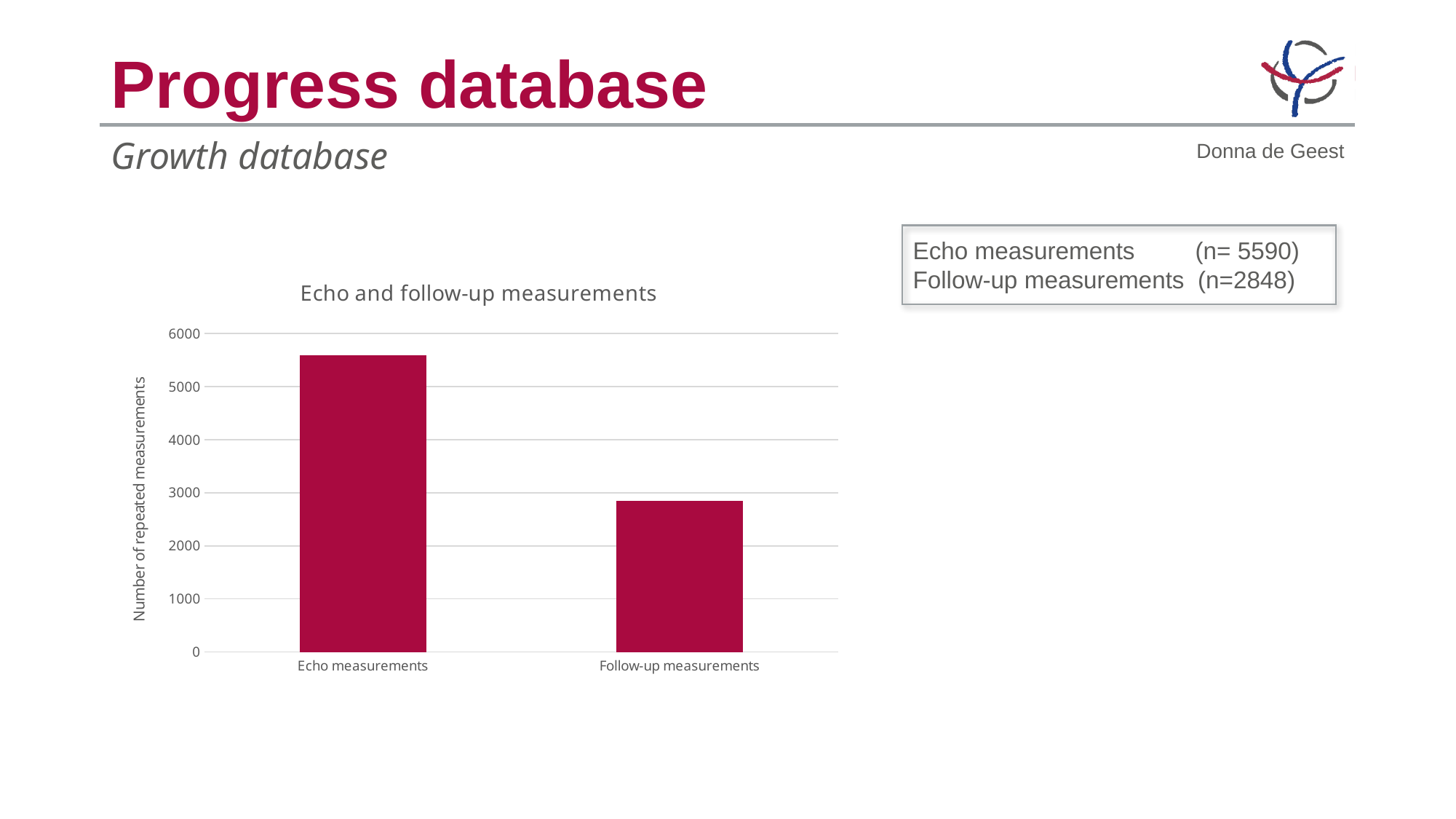
According to the slide, what is the number of Echo measurements (n)? 5590 What is the title of the chart? Echo and follow-up measurements Is the value for Follow-up measurements greater or less than 3000? less Is the value for Echo measurements greater or less than 5000? greater Which category has the highest value in the chart? Echo measurements What is the label of the vertical axis of the chart? Number of repeated measurements According to the slide, what is the number of Follow-up measurements (n)? 2848 Which category has the lowest value in the chart? Follow-up measurements What type of chart is shown on the slide? bar chart Which is larger, the value for Echo measurements or the value for Follow-up measurements? Echo measurements Is the value for Echo measurements greater or less than 6000? less How many categories are plotted in the chart? 2